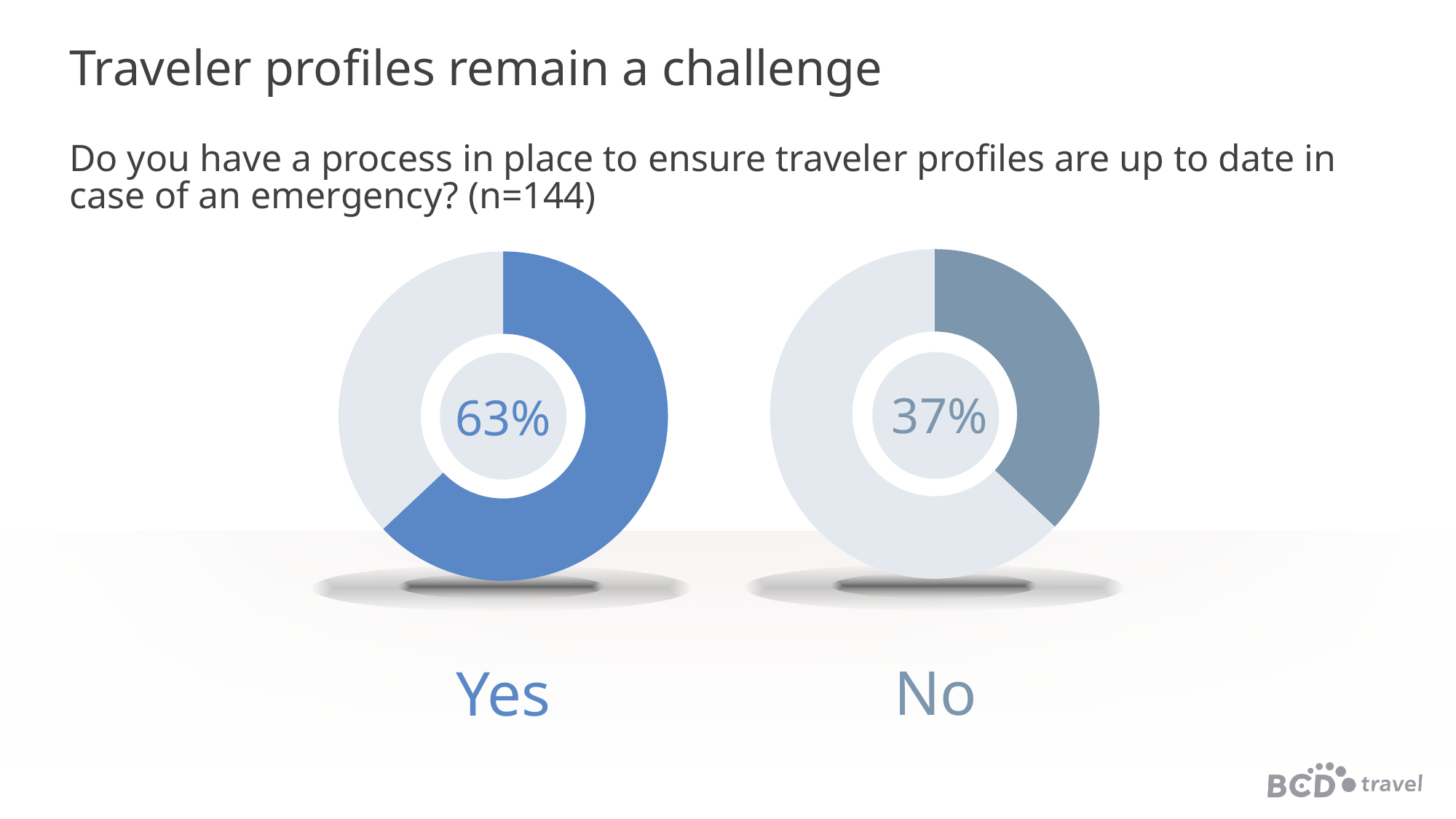
Which response, Yes or No, has the larger share? Yes What is the difference in percentage points between the Yes and No responses? 26 percentage points What is the title of the slide? Traveler profiles remain a challenge How many response categories are shown on the slide? 2 Is the share for No greater or less than 50%? less What percentage of respondents answered No to having a process in place to ensure traveler profiles are up to date? 37% What is the combined total of the Yes and No percentages? 100% Which response has the smallest share? No Is the share for Yes greater or less than 50%? greater How many respondents (n) answered the survey question shown on the slide? 144 What percentage of respondents answered Yes to having a process in place to ensure traveler profiles are up to date? 63% What kind of chart is used to show the Yes and No responses? Doughnut (pie) chart